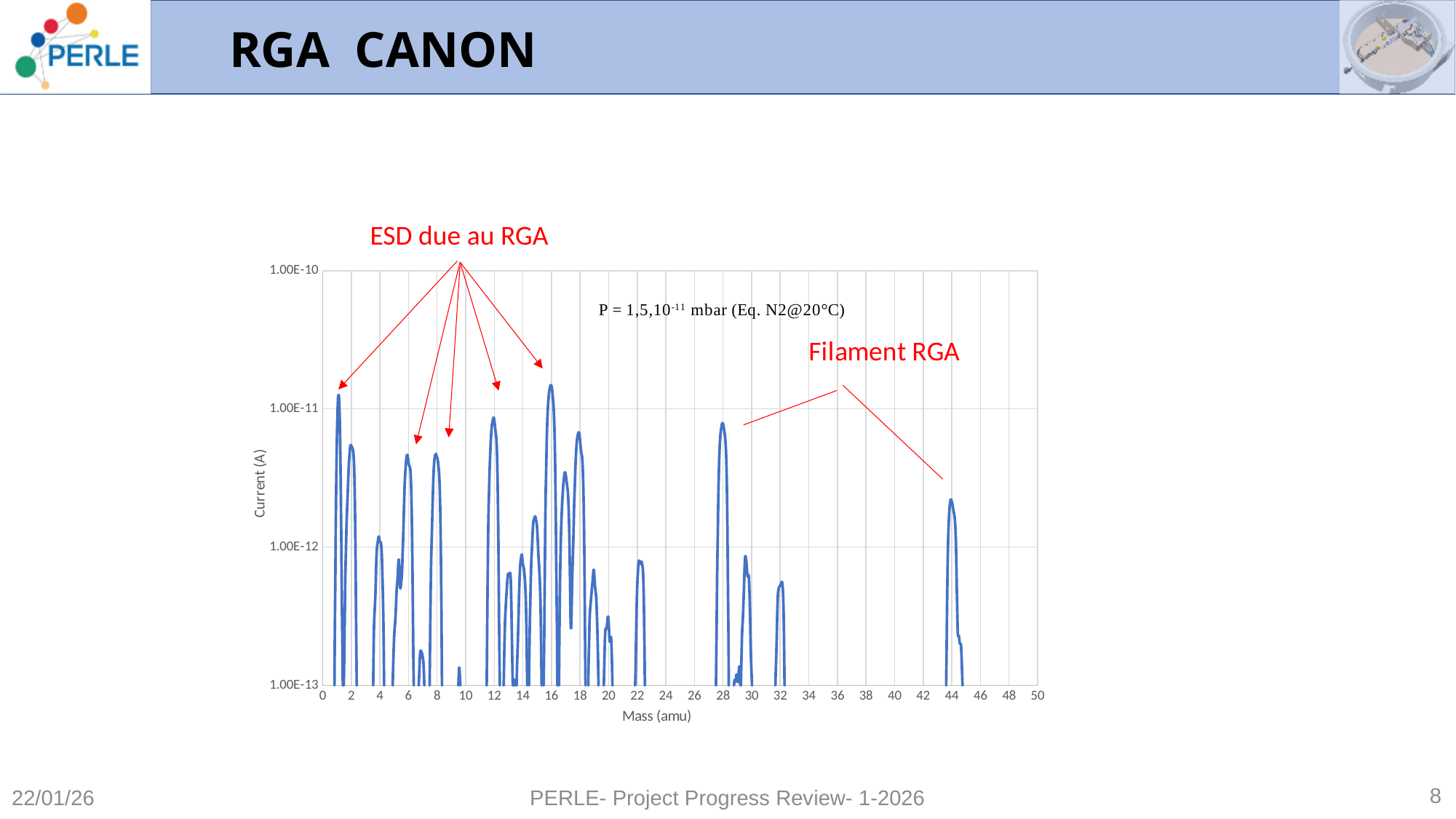
What is the highest value shown on the x axis of the chart? 50 Is the peak current at mass 28 amu greater or less than 1.00E-11? less Is the peak current at mass 4 amu greater or less than 1.00E-11? less Which peak is larger, the one at mass 28 amu or the one at mass 44 amu? mass 28 amu Is the peak current at mass 44 amu greater or less than 1.00E-12? greater What is the label of the x axis of the chart? Mass (amu) At which mass (amu) does the highest peak of the spectrum occur? 16 Which peak is larger, the one at mass 2 amu or the one at mass 4 amu? mass 2 amu What kind of chart is shown on the slide? line chart What is the label of the y axis of the chart? Current (A)